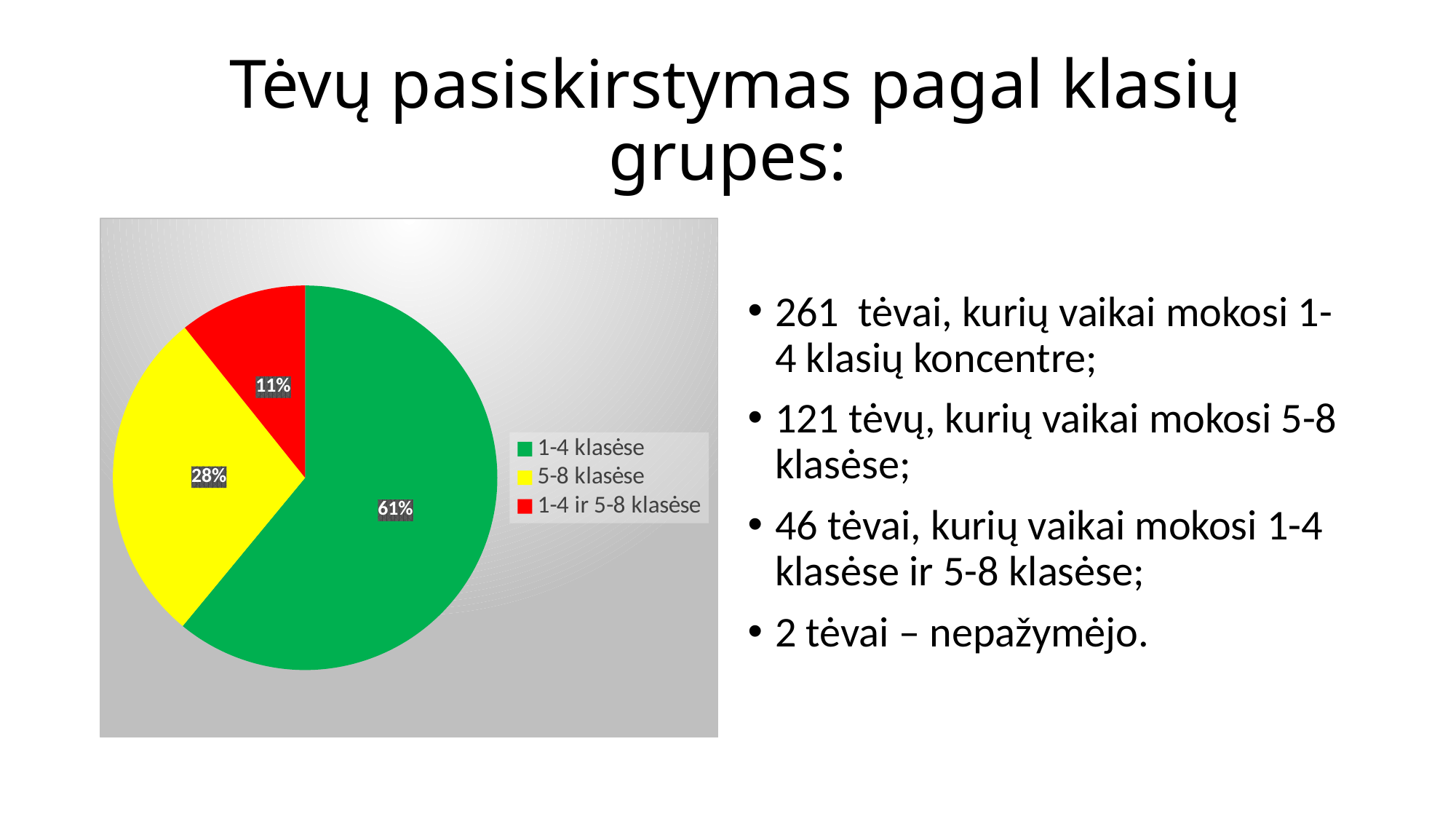
What share of the pie does the "1-4 klasėse" slice represent? 61% What colour is the "5-8 klasėse" slice in the pie chart? Yellow How many slices does the pie chart have? 3 What share of the pie does the "1-4 ir 5-8 klasėse" slice represent? 11% Which slice is larger, "5-8 klasėse" or "1-4 ir 5-8 klasėse"? 5-8 klasėse What is the difference in percentage points between the "5-8 klasėse" and "1-4 ir 5-8 klasėse" slices? 17 What is the difference in percentage points between the "1-4 klasėse" and "5-8 klasėse" slices? 33 What share of the pie does the "5-8 klasėse" slice represent? 28% Which category has the smallest slice of the pie? 1-4 ir 5-8 klasėse What type of chart is shown on the slide? Pie chart Which category has the largest slice of the pie? 1-4 klasėse Which legend entry is shown in red? 1-4 ir 5-8 klasėse